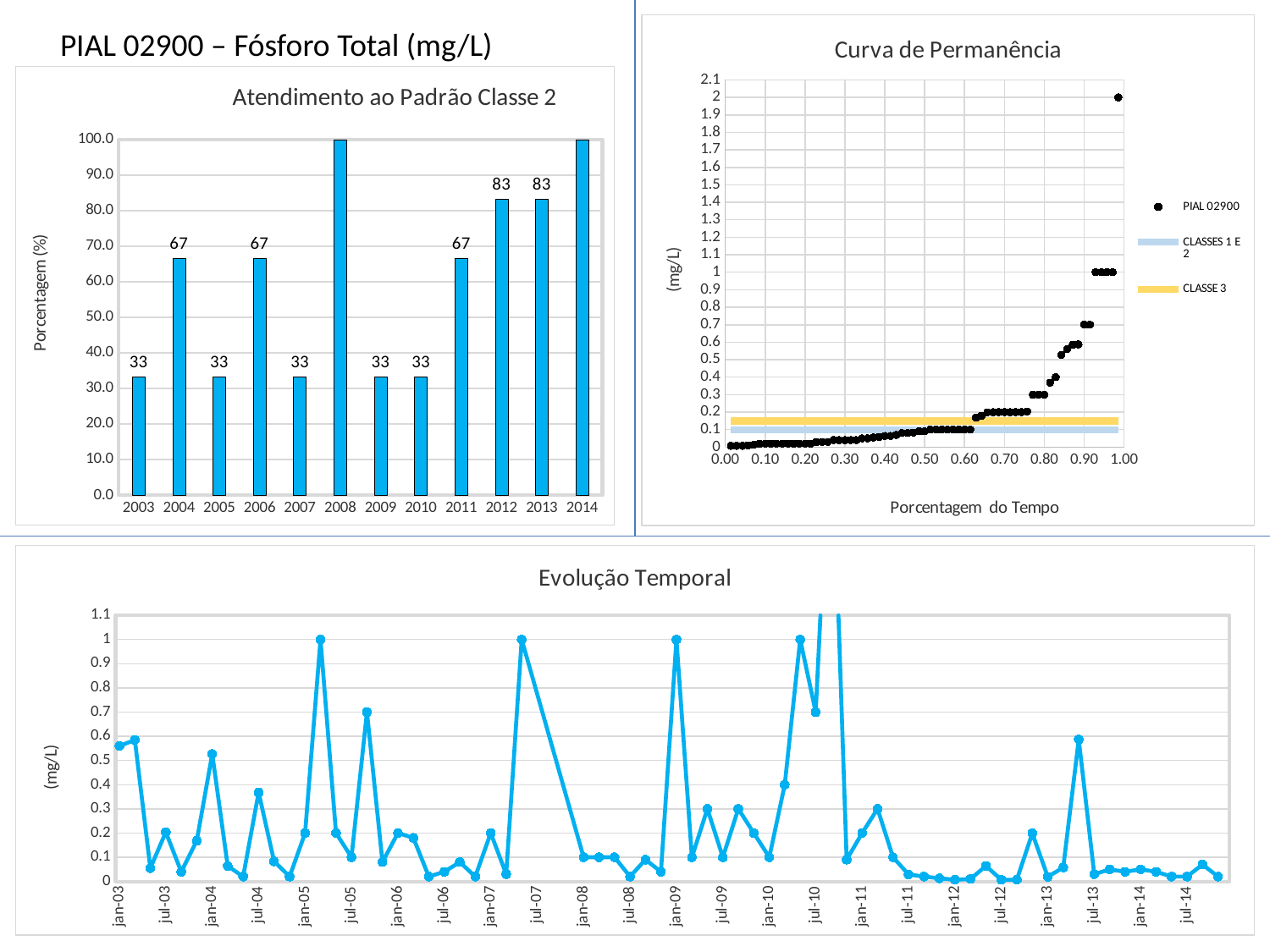
In the 'Atendimento ao Padrão Classe 2' chart, what is the value for 2004? 67 In the 'Atendimento ao Padrão Classe 2' chart, what is the value for 2003? 33 In the 'Curva de Permanência' chart, do the plotted values rise or fall as the x axis increases? rise What is the y-axis label of the 'Evolução Temporal' chart? (mg/L) In the 'Atendimento ao Padrão Classe 2' chart, which is larger, the value for 2006 or the value for 2007? 2006 In the 'Atendimento ao Padrão Classe 2' chart, what is the value for 2012? 83 How many years are shown on the x axis of the 'Atendimento ao Padrão Classe 2' chart? 12 How many entries does the legend of the 'Curva de Permanência' chart list? 3 In the 'Atendimento ao Padrão Classe 2' chart, what is the difference between the values for 2013 and 2011? 16 What is the x-axis title of the 'Curva de Permanência' chart? Porcentagem do Tempo What kind of chart is 'Atendimento ao Padrão Classe 2'? bar chart In the 'Atendimento ao Padrão Classe 2' chart, is the value for 2008 greater or less than 90.0? greater